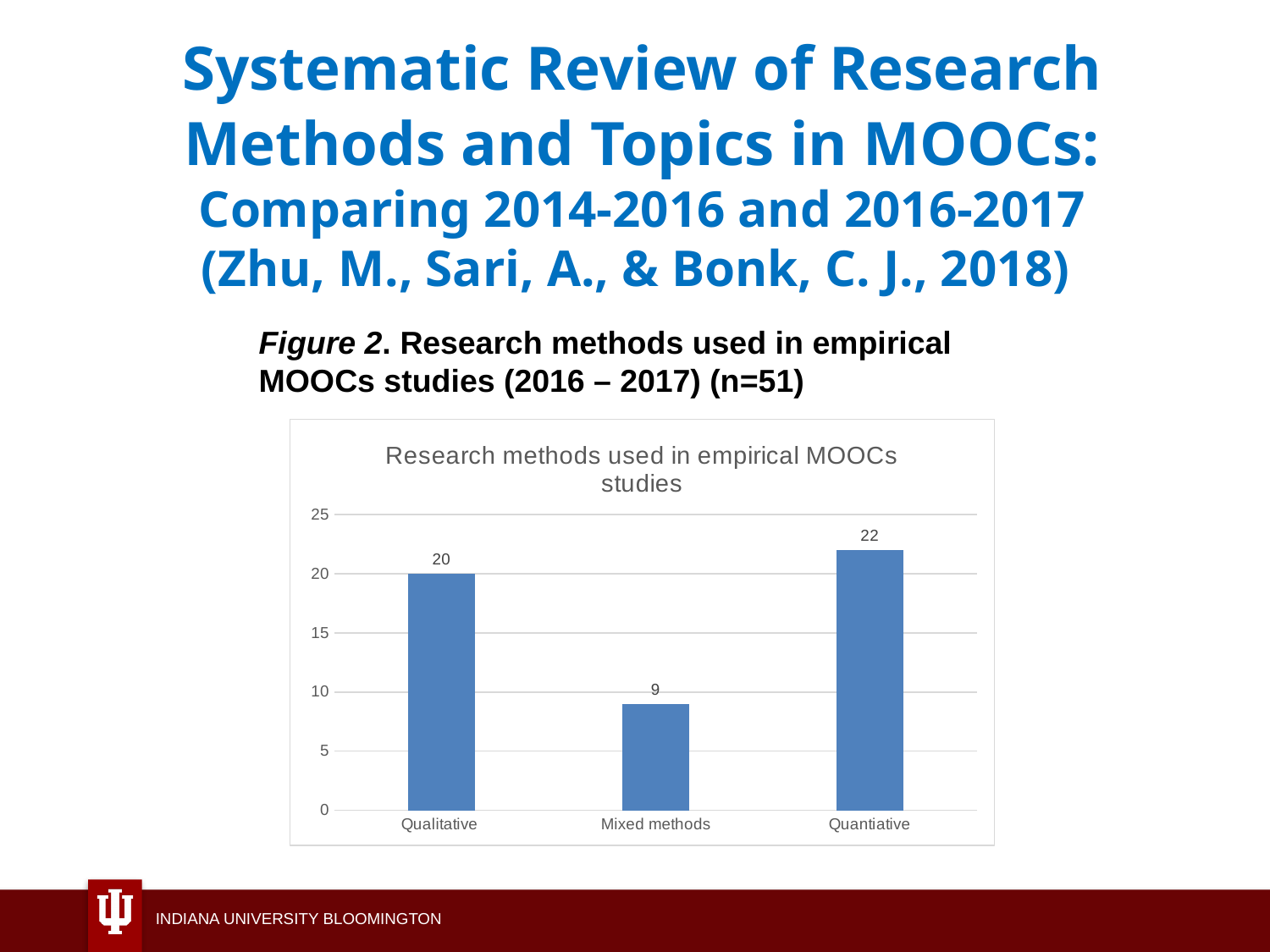
What is the value for Quantiative? 22 What is the difference between the values for Quantiative and Qualitative? 2 Is the value for Mixed methods greater or less than 10? less Which research method has the lowest value? Mixed methods What is the difference between the values for Qualitative and Mixed methods? 11 Which research method has the highest value? Quantiative How many categories are shown on the x axis? 3 Which is larger, the value for Qualitative or the value for Mixed methods? Qualitative What is the title of the chart? Research methods used in empirical MOOCs studies What is the value for Mixed methods? 9 What is the value for Qualitative? 20 What kind of chart is shown on the slide? bar chart